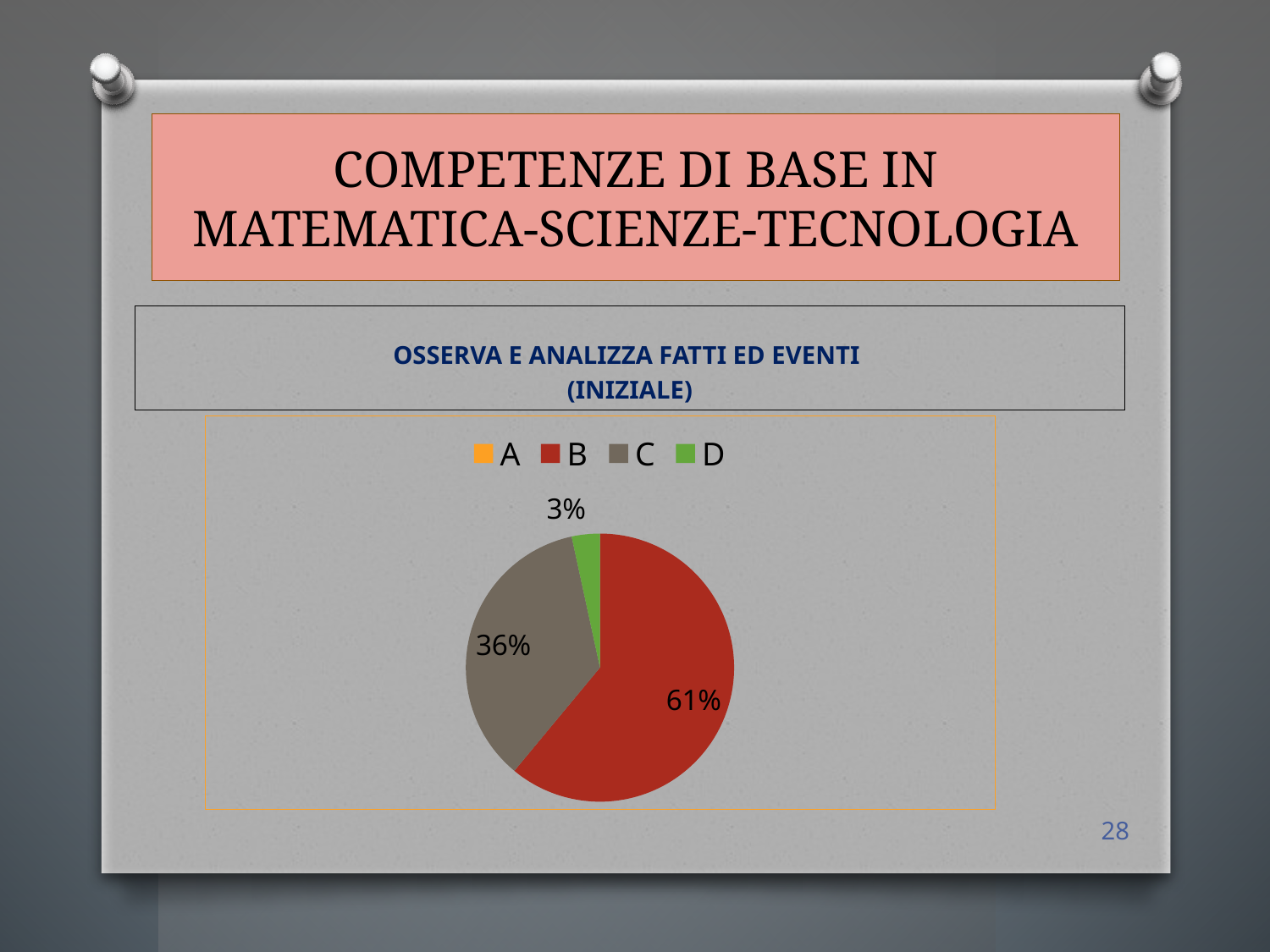
What kind of chart is shown on the slide? Pie chart What percentage of the pie chart is category D? 3% How many categories does the legend of the pie chart list? 4 What is the title shown above the pie chart? OSSERVA E ANALIZZA FATTI ED EVENTI (INIZIALE) What percentage of the pie chart is category B? 61% What percentage of the pie chart is category C? 36% What is the difference in percentage points between category B and category C? 25 Is the share for category B greater or less than 50%? greater Of the slices shown in the pie chart, which is the smallest? D What colour is the slice for category B in the pie chart? Red Which category has the largest slice of the pie chart? B Which is larger, the slice for C or the slice for D? C